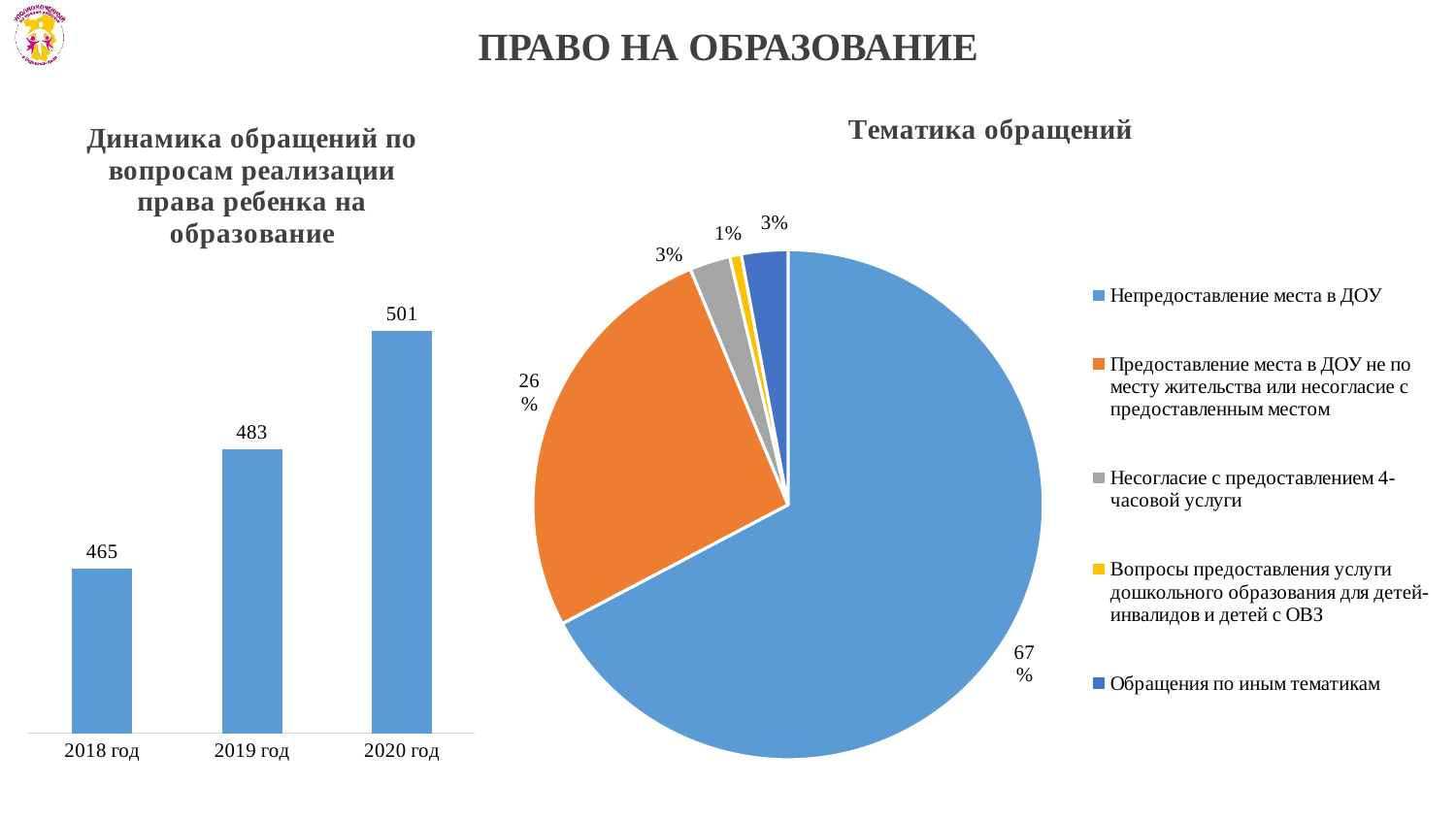
In the pie chart 'Тематика обращений', what share does 'Непредоставление места в ДОУ' have? 67% In the bar chart on the left, which year has the lowest value? 2018 год In the bar chart on the left, what is the value for 2020 год? 501 In the bar chart on the left, which year has the highest value? 2020 год What kind of chart is the chart titled 'Тематика обращений'? pie chart How many bars are in the bar chart on the left? 3 In the pie chart 'Тематика обращений', what share does 'Вопросы предоставления услуги дошкольного образования для детей-инвалидов и детей с ОВЗ' have? 1% In the bar chart on the left, what is the value for 2018 год? 465 In the bar chart on the left, do the values rise or fall from 2018 год to 2020 год? rise In the pie chart 'Тематика обращений', which category has the largest slice? Непредоставление места в ДОУ In the bar chart on the left, what is the difference between the values for 2020 год and 2018 год? 36 How many categories does the legend of the pie chart 'Тематика обращений' list? 5